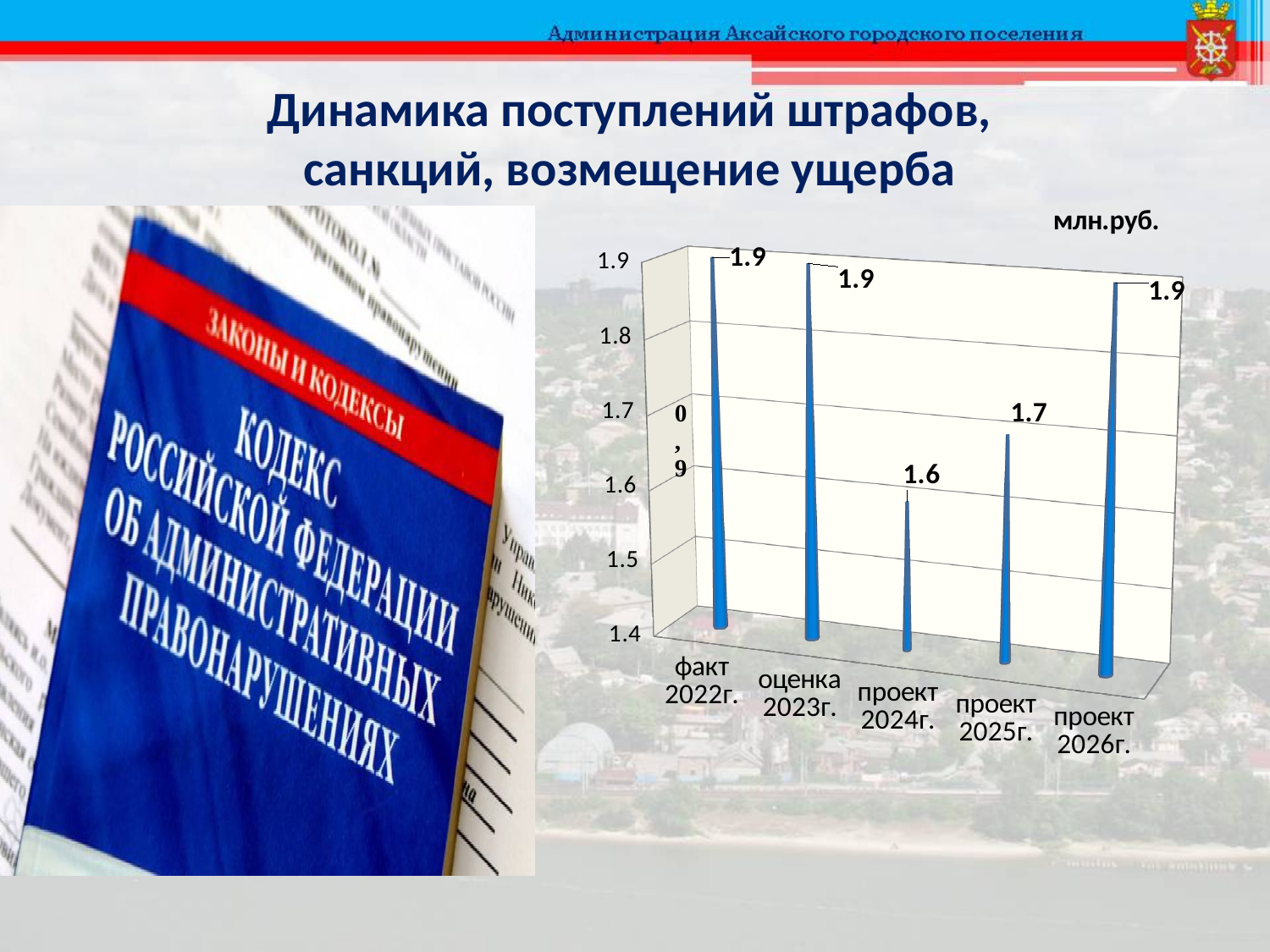
What is the difference between the values for оценка 2023г. and проект 2024г.? 0.3 How many categories are shown on the chart? 5 What kind of chart is shown on the slide? bar chart Is the value for проект 2024г. greater or less than 1.7? less What is the difference between the values for проект 2026г. and проект 2025г.? 0.2 Which category has the lowest value? проект 2024г. What is the value for проект 2026г.? 1.9 What is the value for проект 2024г.? 1.6 What is the value for проект 2025г.? 1.7 What unit is indicated above the chart? млн.руб. Which is larger, the value for проект 2025г. or the value for проект 2024г.? проект 2025г. What is the value for факт 2022г.? 1.9